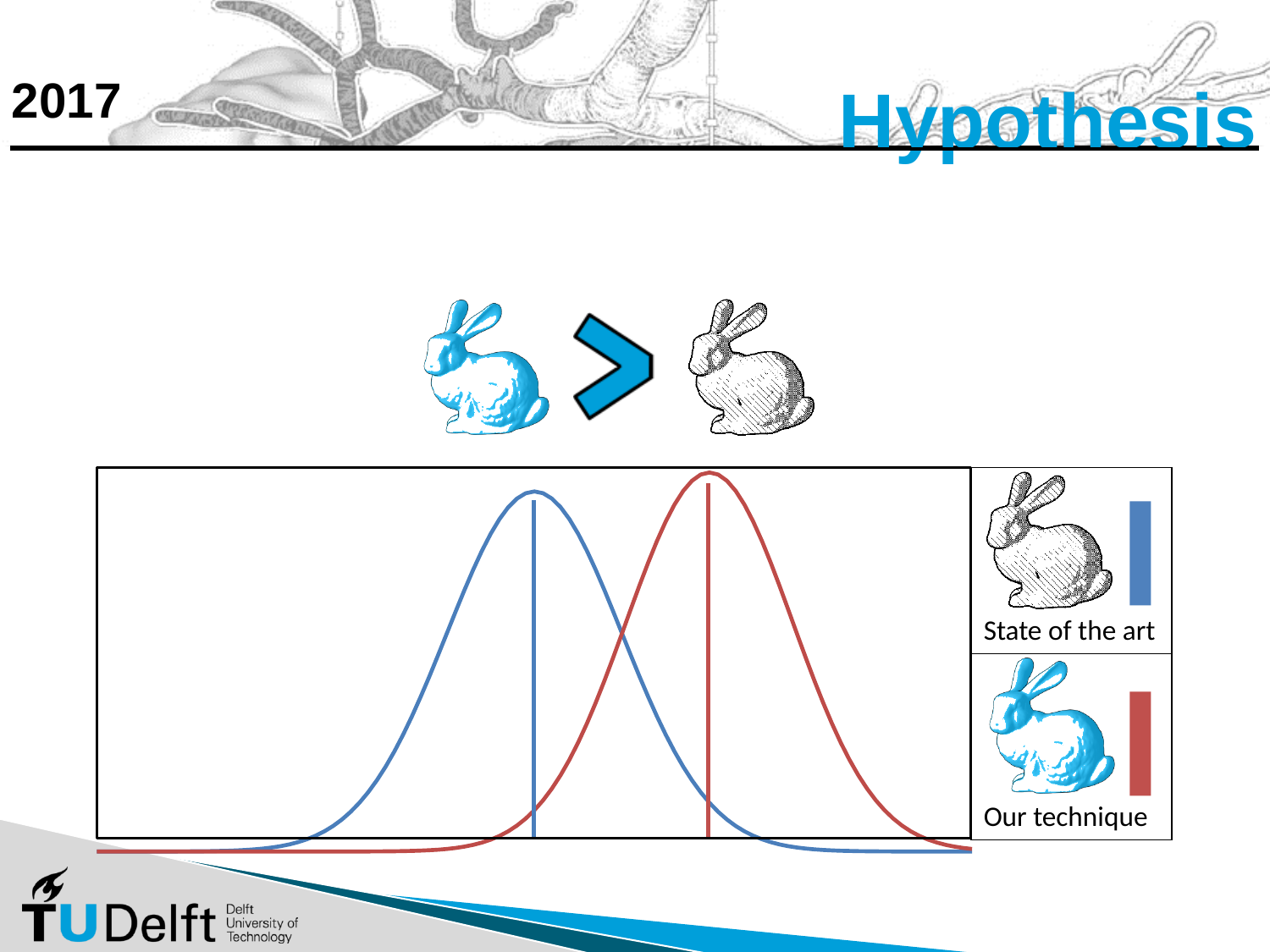
What is the title of the slide containing the chart? Hypothesis Which series has its peak further to the right along the x axis, "State of the art" or "Our technique"? Our technique Which series has its peak further to the left along the x axis, "State of the art" or "Our technique"? State of the art What kind of chart is shown on the slide? line chart Which colour represents "State of the art" in the chart's legend? blue Which colour represents "Our technique" in the chart's legend? red How many series does the legend list in the chart? 2